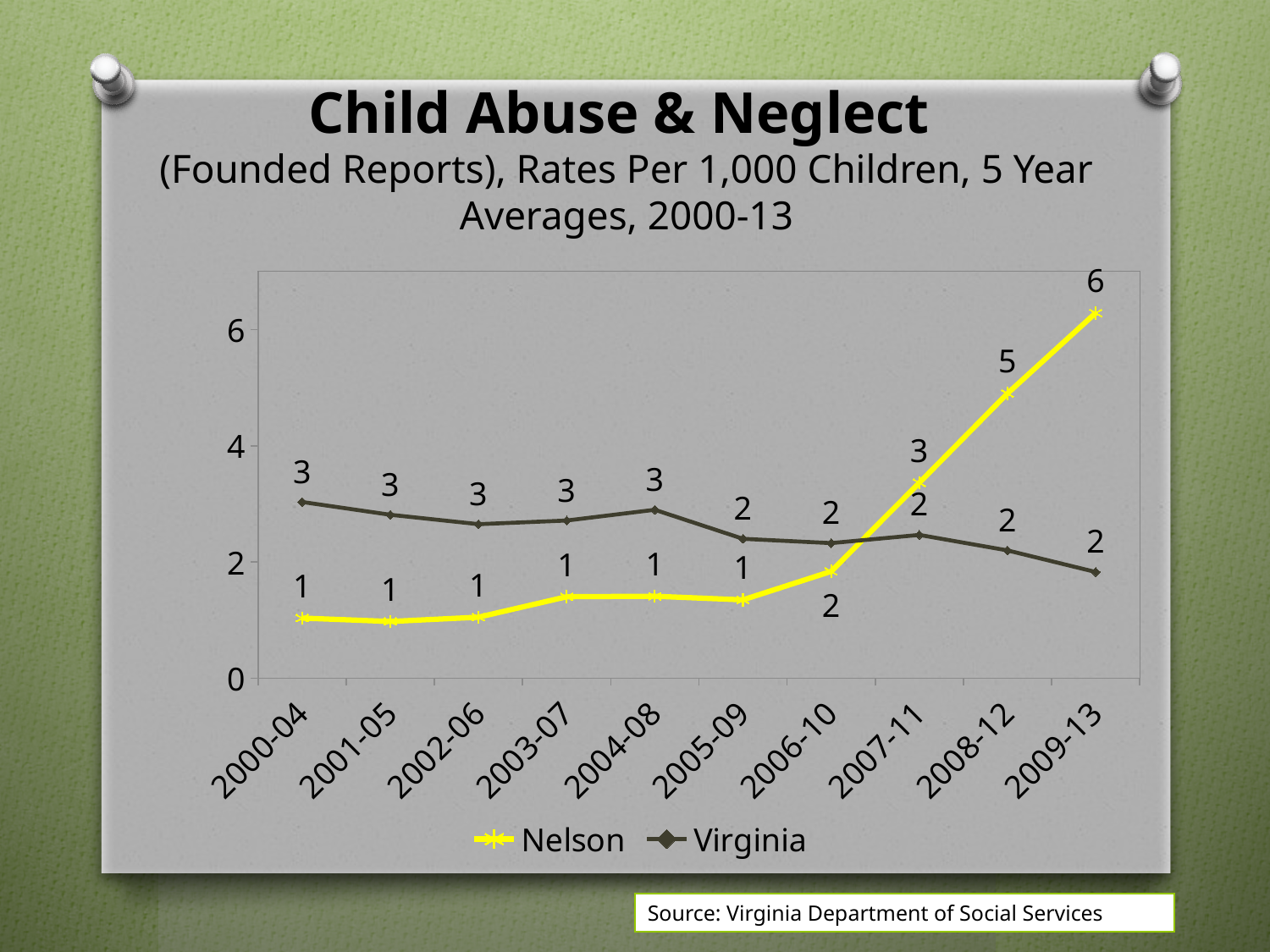
What is the value for Virginia in 2009-13? 2 In which period does Nelson reach its highest value? 2009-13 In 2009-13, which series has the larger value, Nelson or Virginia? Nelson What is the difference between the Nelson and Virginia values in 2009-13? 4 In 2000-04, which series has the larger value, Nelson or Virginia? Virginia What kind of chart is shown on the slide? Line chart How many series does the legend list? 2 What is the value for Nelson in 2008-12? 5 Does the Nelson line rise or fall from 2006-10 to 2009-13? Rise What is the value for Virginia in 2000-04? 3 How many time periods are plotted along the x axis? 10 What is the value for Nelson in 2009-13? 6